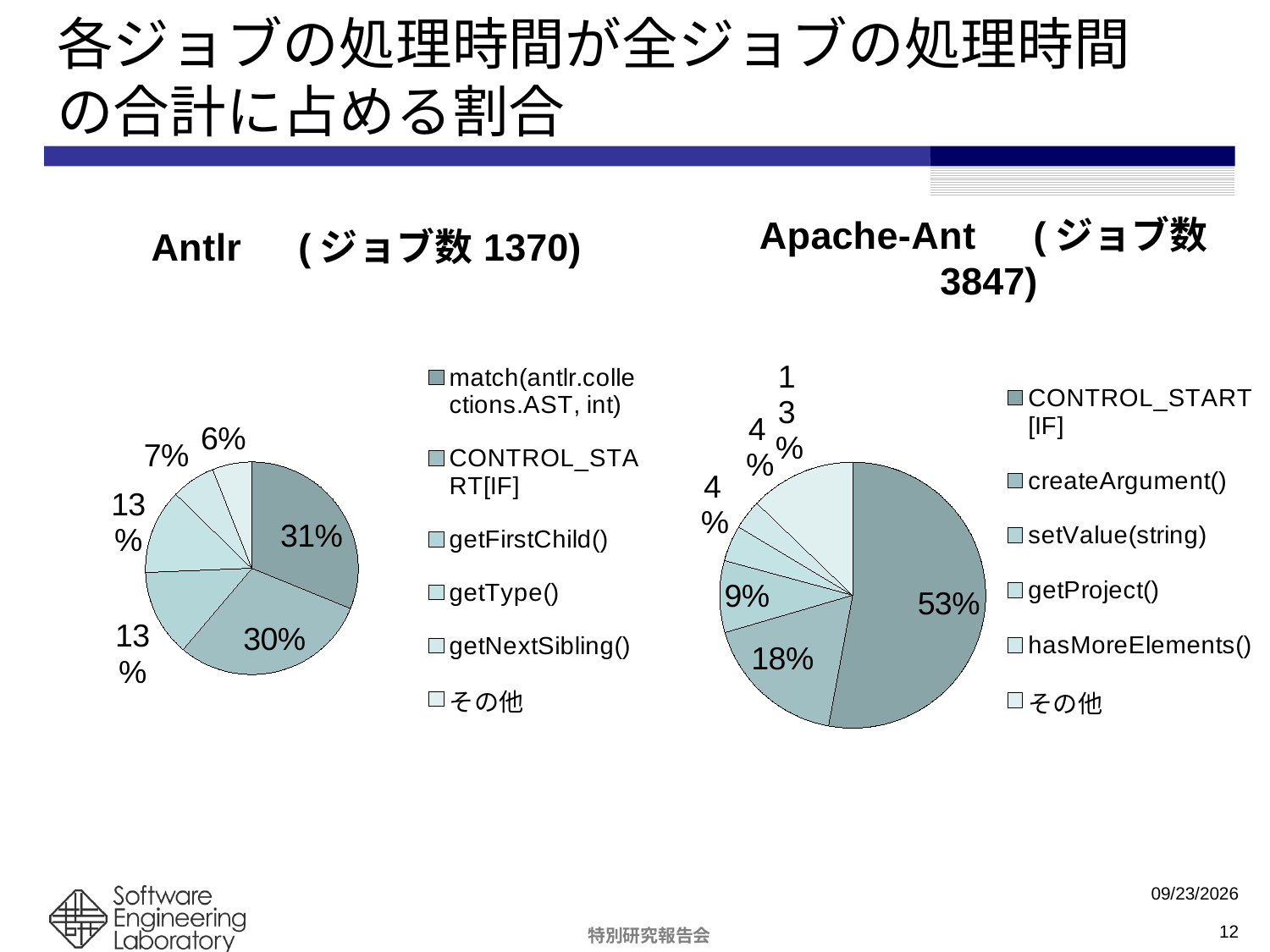
What kind of chart is the Antlr chart on the left? pie chart In the Antlr pie chart, what share does match(antlr.collections.AST, int) have? 31% In the Apache-Ant pie chart, which category has the largest share? CONTROL_START[IF] In the Apache-Ant pie chart, what share does setValue(string) have? 9% How many entries does the legend of the Antlr pie chart list? 6 In the Antlr pie chart, what share does CONTROL_START[IF] have? 30% Which is larger: the share of CONTROL_START[IF] in the Antlr chart or in the Apache-Ant chart? Apache-Ant In the Apache-Ant pie chart, what is the difference between the shares of CONTROL_START[IF] and createArgument()? 35% In the Antlr pie chart, which category has the smallest share? その他